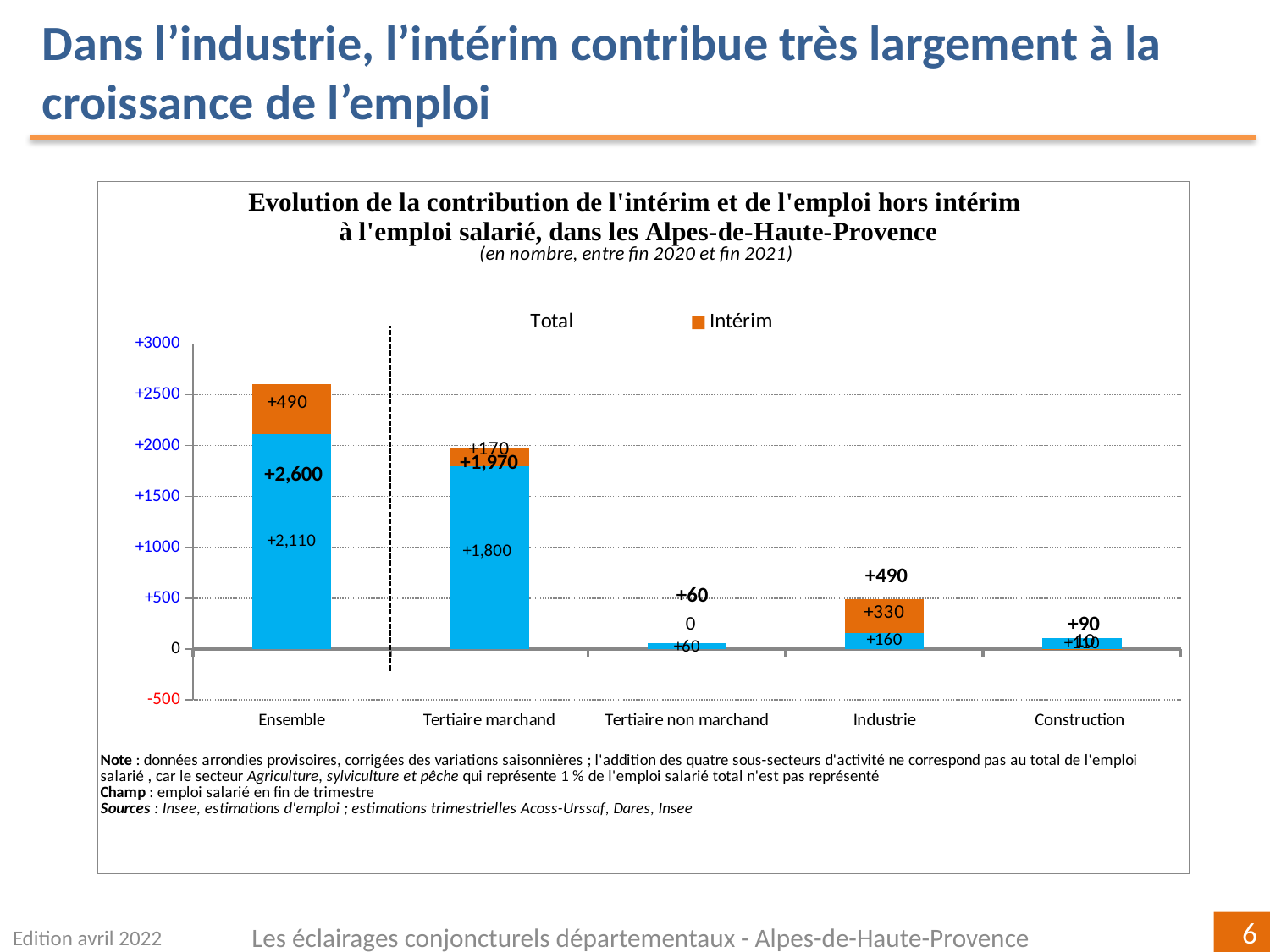
What is the Intérim value for Tertiaire non marchand? 0 What kind of chart is shown on the slide? Stacked bar chart What is the Intérim value for Ensemble? +490 What is the total value shown for Ensemble? +2,600 How many categories are shown on the x axis? 5 What is the Intérim value for Industrie? +330 Is the total value for Ensemble greater or less than 2500? greater What is the difference between the Intérim value for Industrie and the Intérim value for Tertiaire marchand? 160 Among the four sub-sectors (excluding Ensemble), which has the lowest total value? Tertiaire non marchand What is the total value shown for Tertiaire marchand? +1,970 Which category has the highest total value? Ensemble Which has the larger Intérim value, Industrie or Tertiaire marchand? Industrie